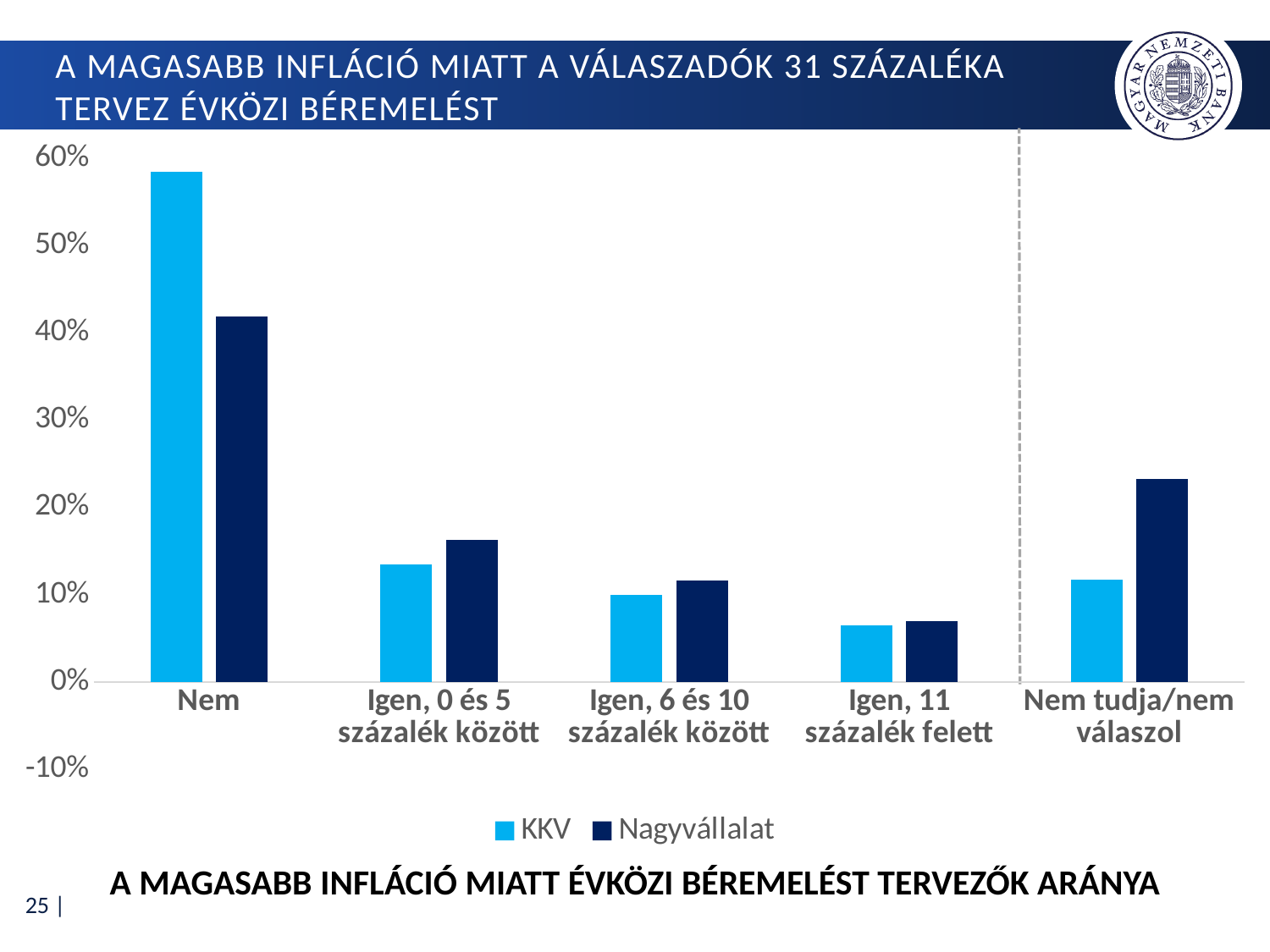
How many categories are shown on the x axis? 5 Which category has the highest value for KKV? Nem For the category Nem tudja/nem válaszol, which series has the larger value, KKV or Nagyvállalat? Nagyvállalat Is the KKV value for Nem greater or less than 50%? greater Which category has the lowest value for KKV? Igen, 11 százalék felett Which category has the highest value for Nagyvállalat? Nem For the category Nem, which series has the larger value, KKV or Nagyvállalat? KKV How many series does the legend list? 2 Which category has the lowest value for Nagyvállalat? Igen, 11 százalék felett Is the Nagyvállalat value for Nem tudja/nem válaszol greater or less than 20%? greater What are the two entries in the chart's legend? KKV and Nagyvállalat What kind of chart is shown on the slide? bar chart